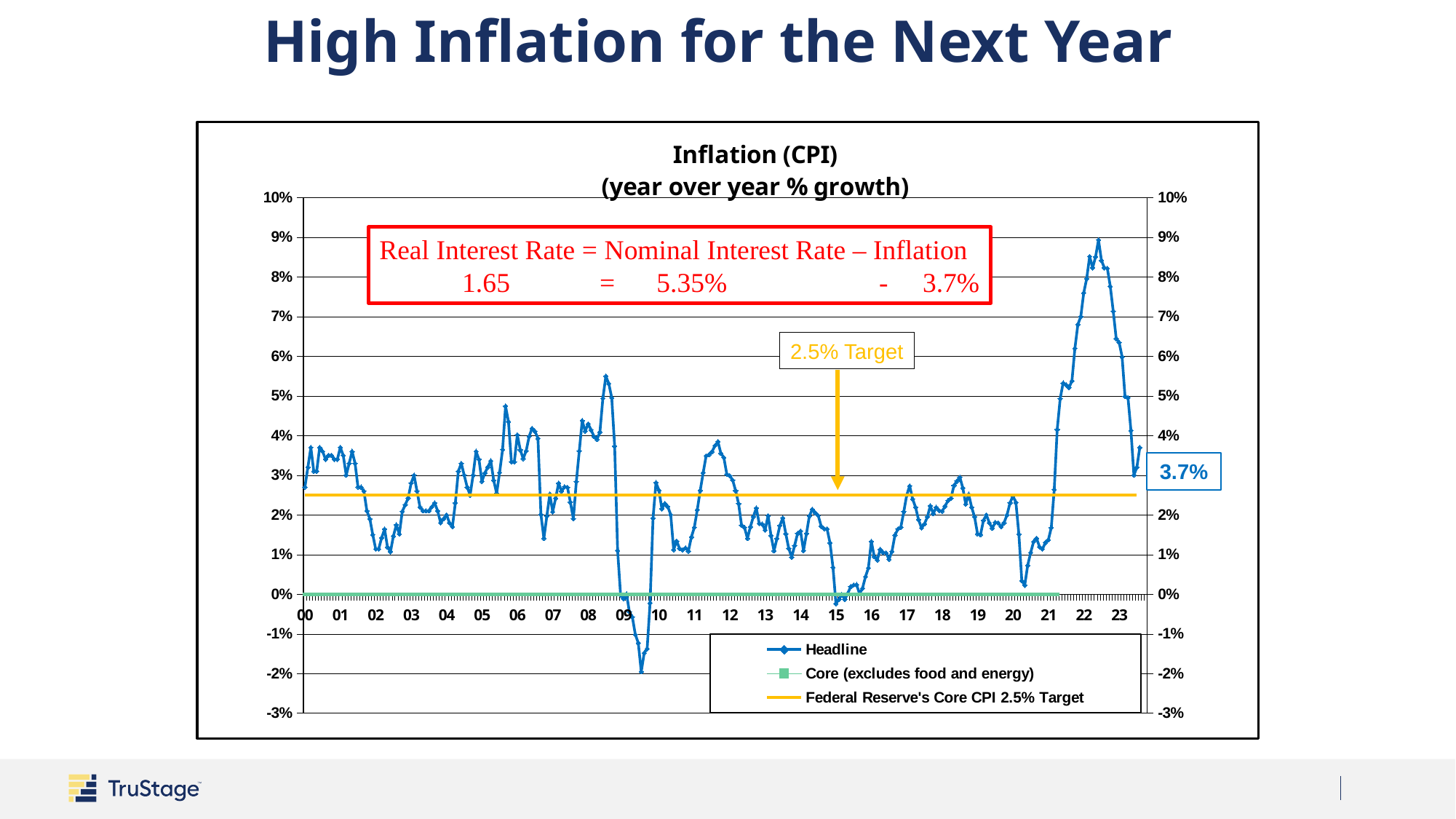
What is the value of the Federal Reserve's Core CPI target line? 2.5% Which is larger: the Headline peak around 2008 or the Headline peak around 2022? 2022 Is the lowest Headline inflation value around 2009 greater or less than -1%? less Is the peak Headline inflation value around 2022 greater or less than 8%? greater What is the full legend label for the Core series? Core (excludes food and energy) How many series does the chart legend list? 3 In which year does the Headline series reach its lowest value? 2009 What is the most recent Headline inflation value labeled on the chart? 3.7% What is the title of the chart? Inflation (CPI) (year over year % growth) What kind of chart is shown on the slide? line chart Does the Headline series rise or fall from its 2022 peak to 2023? fall In which year does the Headline series reach its highest value? 2022